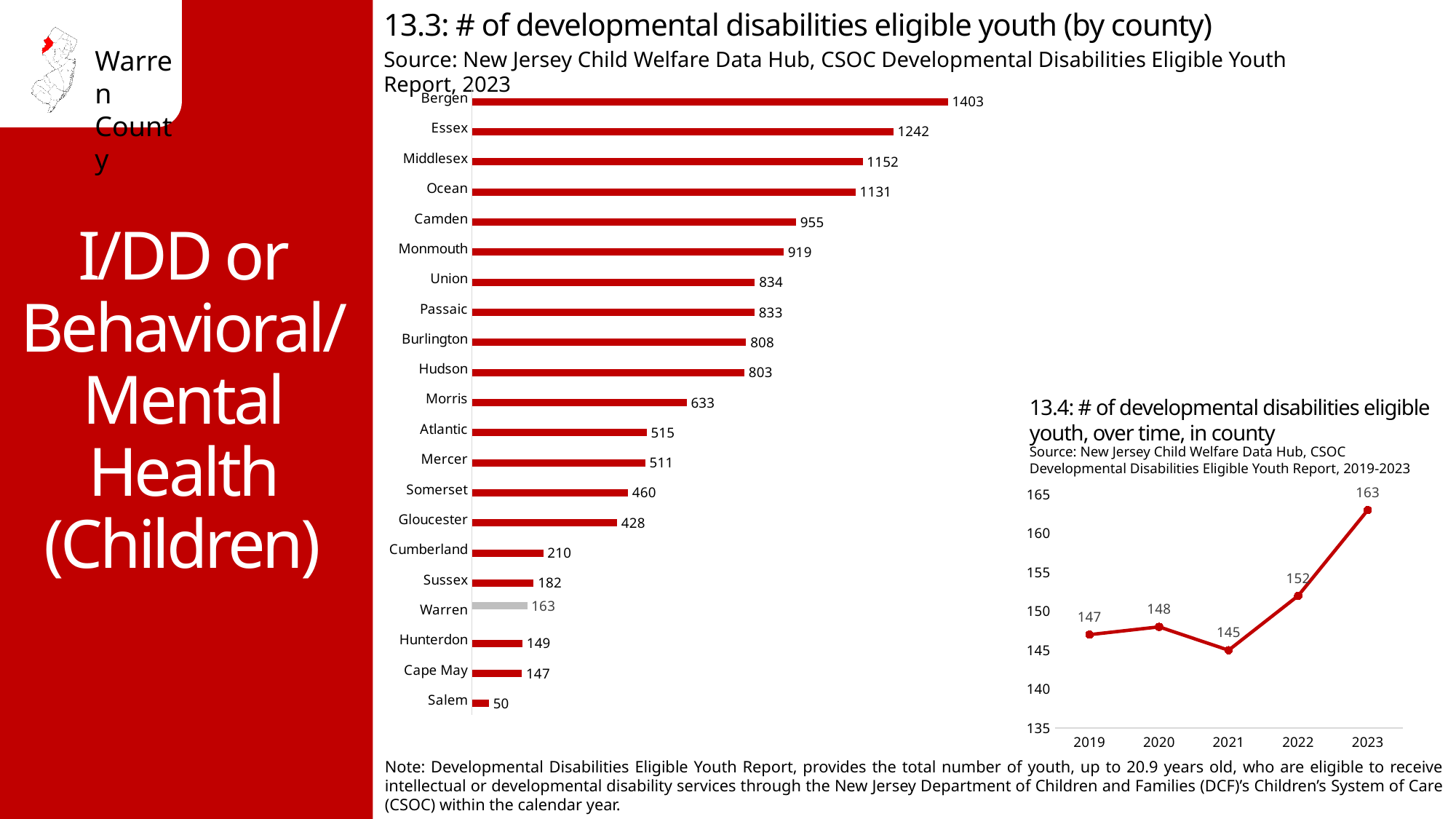
In chart 13.4 (over time, in county), what is the value for 2021? 145 In chart 13.3 (by county), what is the value for Camden? 955 In chart 13.3 (by county), which county has the highest number of developmental disabilities eligible youth? Bergen In chart 13.3 (by county), which is larger, the value for Morris or the value for Atlantic? Morris What kind of chart is chart 13.3 (by county)? Bar chart In chart 13.3 (by county), what is the difference between Bergen and Essex? 161 In chart 13.4 (over time, in county), what is the difference between the 2023 and 2022 values? 11 In chart 13.3 (by county), how many counties are shown? 21 In chart 13.4 (over time, in county), which year has the highest value? 2023 What kind of chart is chart 13.4 (over time, in county)? Line chart In chart 13.3 (# of developmental disabilities eligible youth by county), what is the value for Warren? 163 In chart 13.3 (by county), which county has the lowest number of developmental disabilities eligible youth? Salem